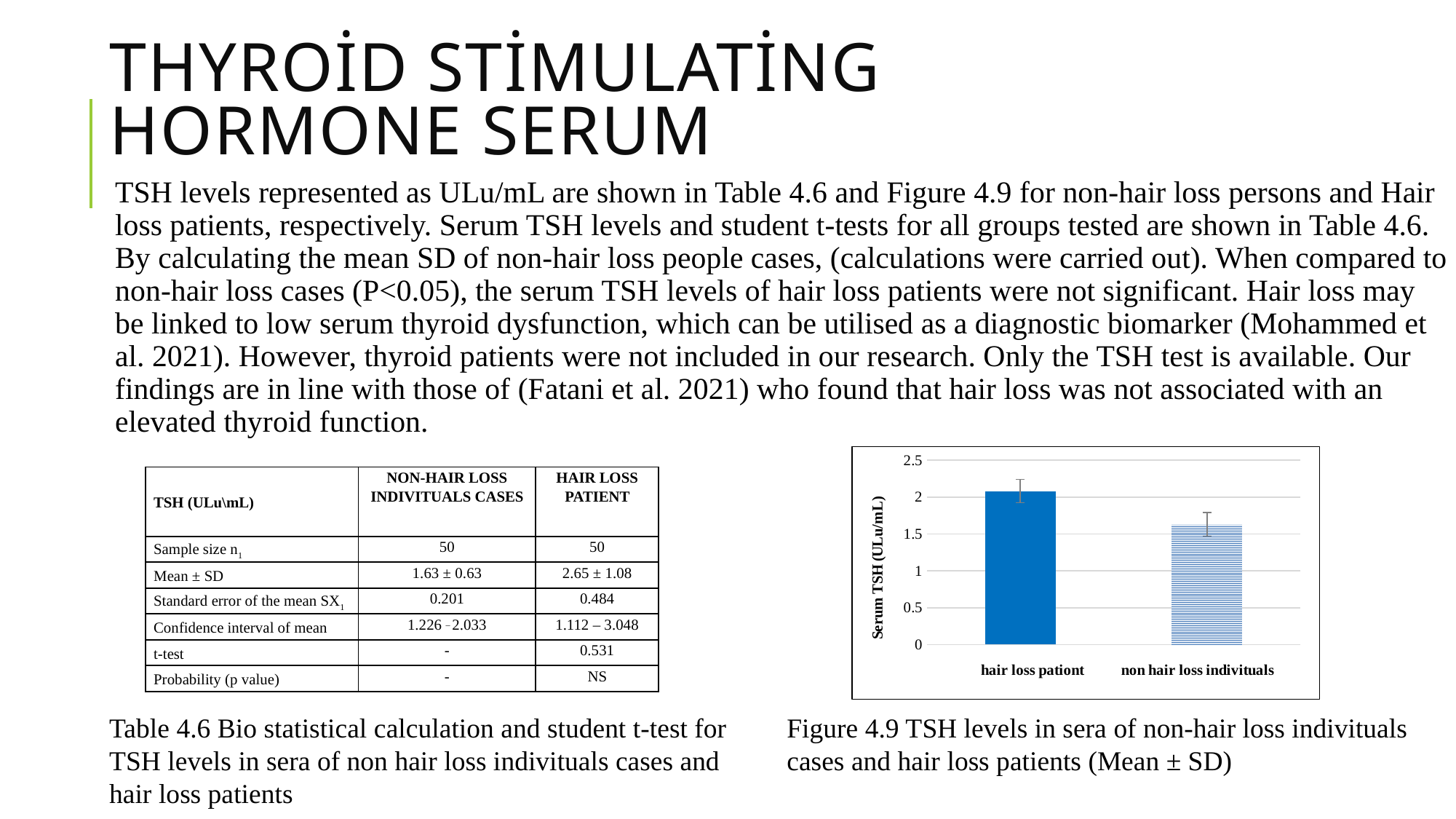
Which category has the lowest bar in the chart? non hair loss individuals Is the value for non hair loss individuals greater or less than 1? greater Which bar is taller, hair loss pationt or non hair loss individuals? hair loss pationt Which category has the highest bar in the chart? hair loss pationt What kind of chart is shown on the slide? bar chart Is the value for hair loss pationt greater or less than 2.5? less What is the highest tick value shown on the vertical axis of the chart? 2.5 How many categories are plotted in the bar chart? 2 What is the label of the vertical axis of the chart? Serum TSH (ULu/mL) Is the value for non hair loss individuals greater or less than 2? less